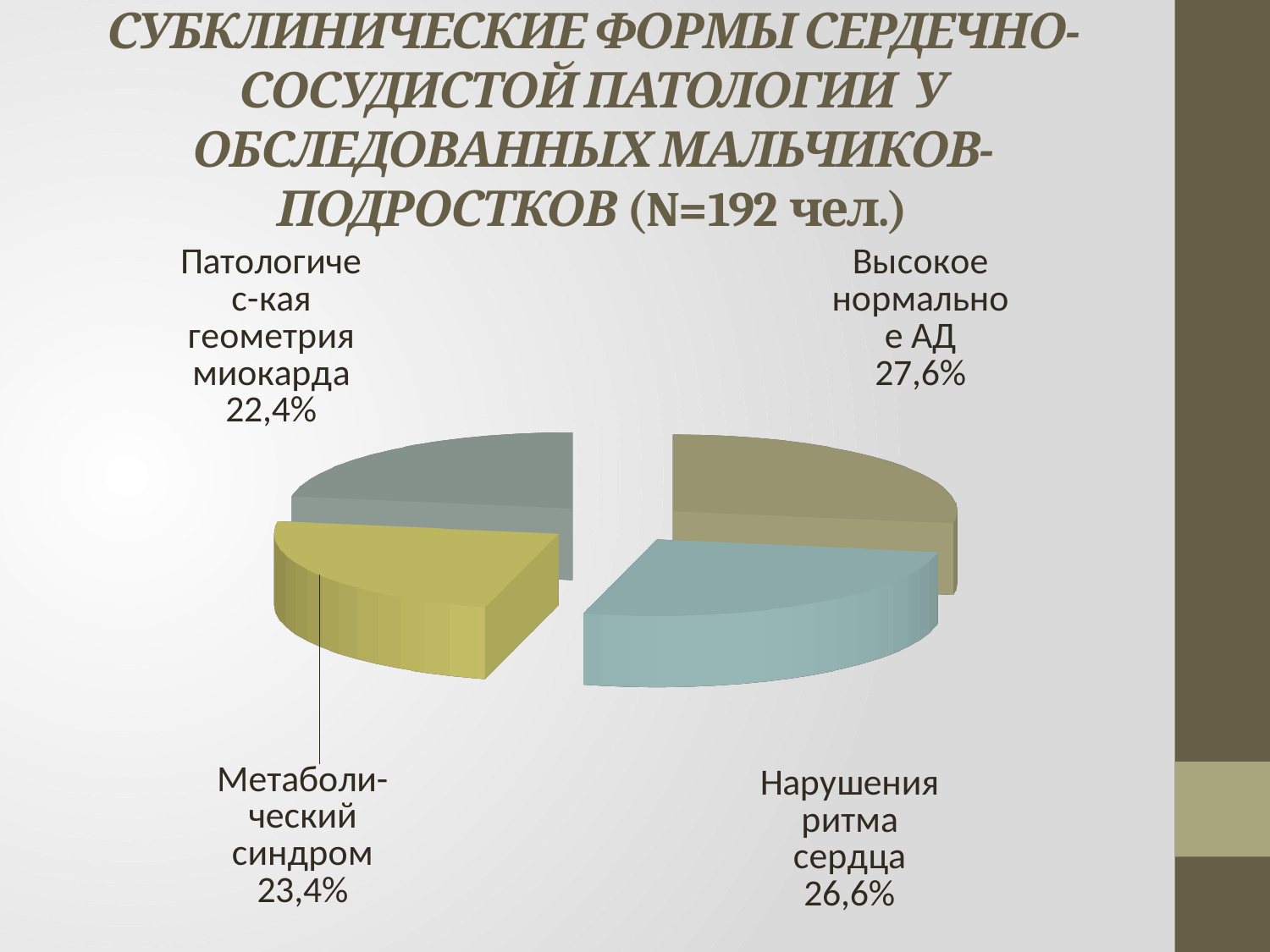
What is the difference in percentage points between "Нарушения ритма сердца" and "Метаболический синдром"? 3,2 Which is larger: the slice for "Нарушения ритма сердца" or the slice for "Метаболический синдром"? Нарушения ритма сердца What share of the pie does the slice "Высокое нормальное АД" represent? 27,6% According to the slide title, how many adolescent boys were examined (N)? 192 Which category has the smallest slice of the pie? Патологическая геометрия миокарда Which category has the largest slice of the pie? Высокое нормальное АД What value is shown for "Метаболический синдром"? 23,4% What kind of chart is shown on the slide? Pie chart How many slices does the pie chart have? 4 What value is shown for "Нарушения ритма сердца"? 26,6% What value is shown for "Патологическая геометрия миокарда"? 22,4% What is the difference in percentage points between "Высокое нормальное АД" and "Патологическая геометрия миокарда"? 5,2